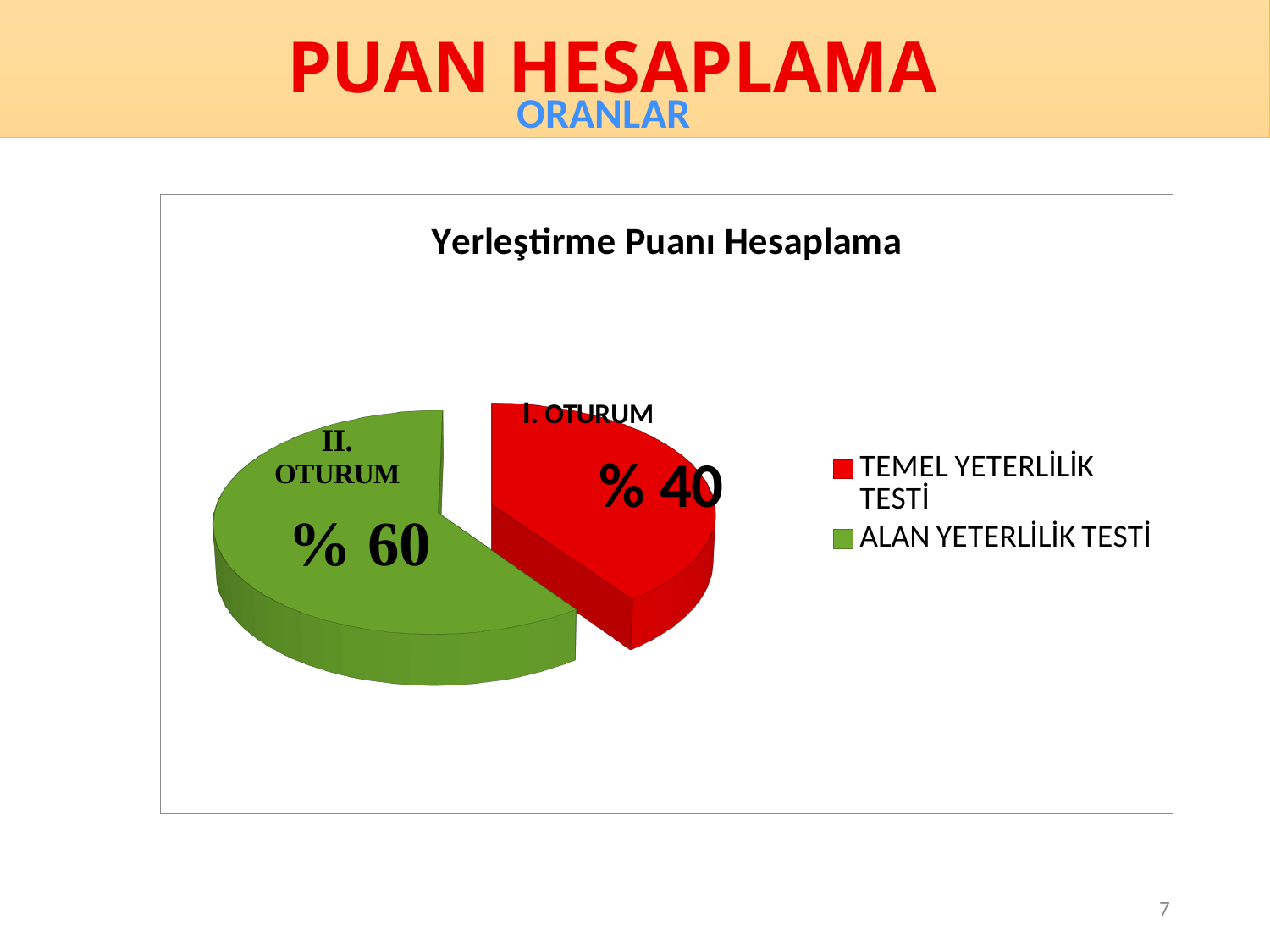
What share of the pie does TEMEL YETERLİLİK TESTİ (I. OTURUM) represent? % 40 What share of the pie does ALAN YETERLİLİK TESTİ (II. OTURUM) represent? % 60 Which slice of the pie is the largest? ALAN YETERLİLİK TESTİ How many slices does the pie chart have? 2 Which slice of the pie is the smallest? TEMEL YETERLİLİK TESTİ What is the title of the chart? Yerleştirme Puanı Hesaplama What is the difference in percentage points between the II. OTURUM slice and the I. OTURUM slice? 20 Which is larger, the TEMEL YETERLİLİK TESTİ slice or the ALAN YETERLİLİK TESTİ slice? ALAN YETERLİLİK TESTİ What type of chart is shown on the slide? pie chart How many entries does the legend list? 2 What colour is the ALAN YETERLİLİK TESTİ slice? green